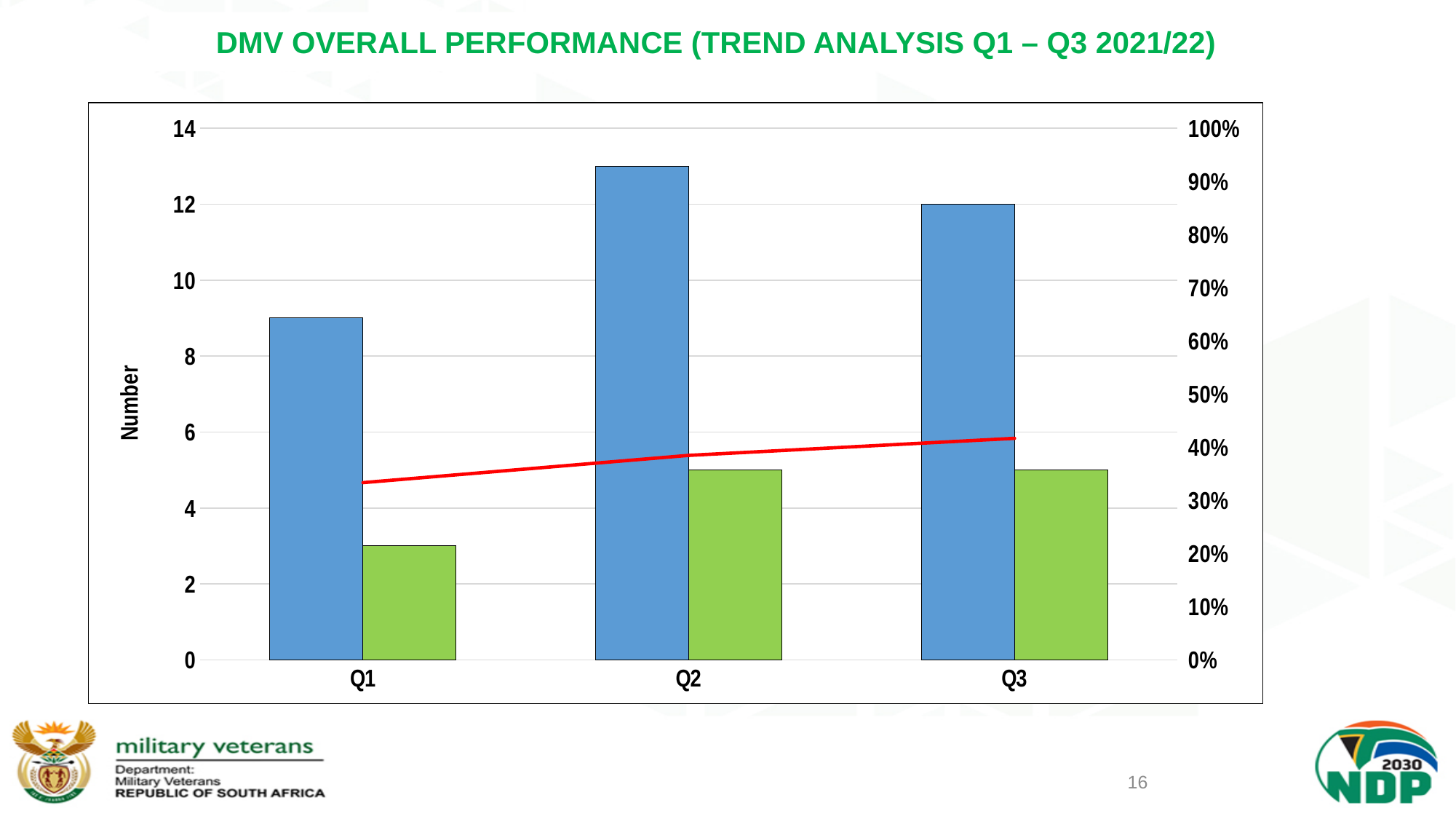
What kind of chart is shown on the slide? combination bar and line chart Is the value of the blue bar for Q1 greater or less than 8? greater What is the title of the left vertical axis? Number How many quarters are shown on the x axis of the chart? 3 Is the value of the green bar for Q2 greater or less than 4? greater Which quarter has the highest blue bar? Q2 Which quarter has the lowest green bar? Q1 Is the value of the green bar for Q1 greater or less than 4? less Does the red line rise or fall from Q1 to Q3? rise Which quarter has the lowest blue bar? Q1 What is the value of the blue bar for Q3? 12